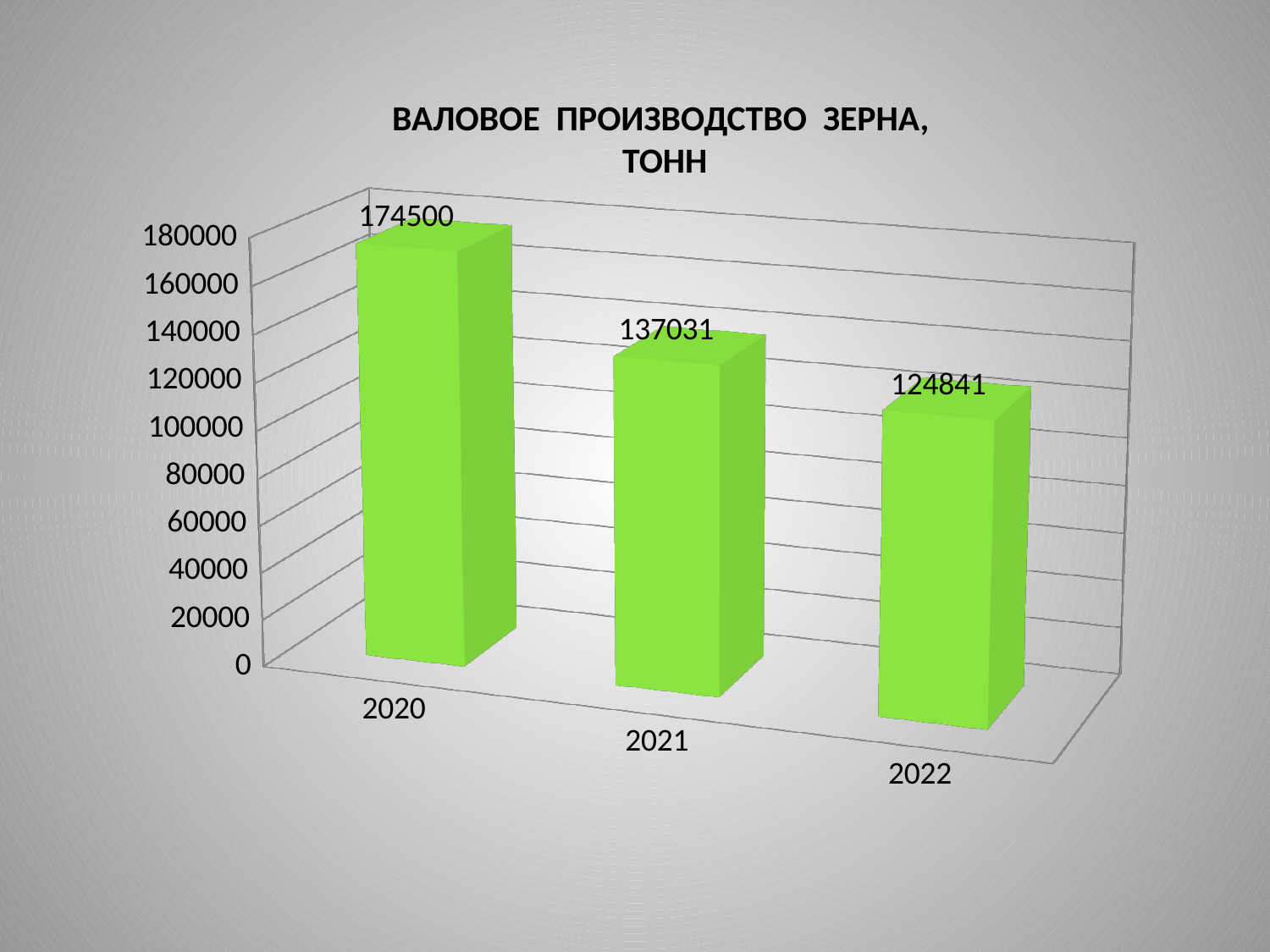
What is the difference between the values for 2020 and 2021? 37469 How many years are shown on the chart? 3 What kind of chart is this? bar chart What is the difference between the values for 2021 and 2022? 12190 What is the value for 2022? 124841 Is the value for 2022 greater or less than 140000? less Which year has the highest value? 2020 What is the value for 2021? 137031 Which year has the lowest value? 2022 Do the values rise or fall from 2020 to 2022? fall Which is larger, the value for 2021 or the value for 2022? 2021 What is the value for 2020? 174500